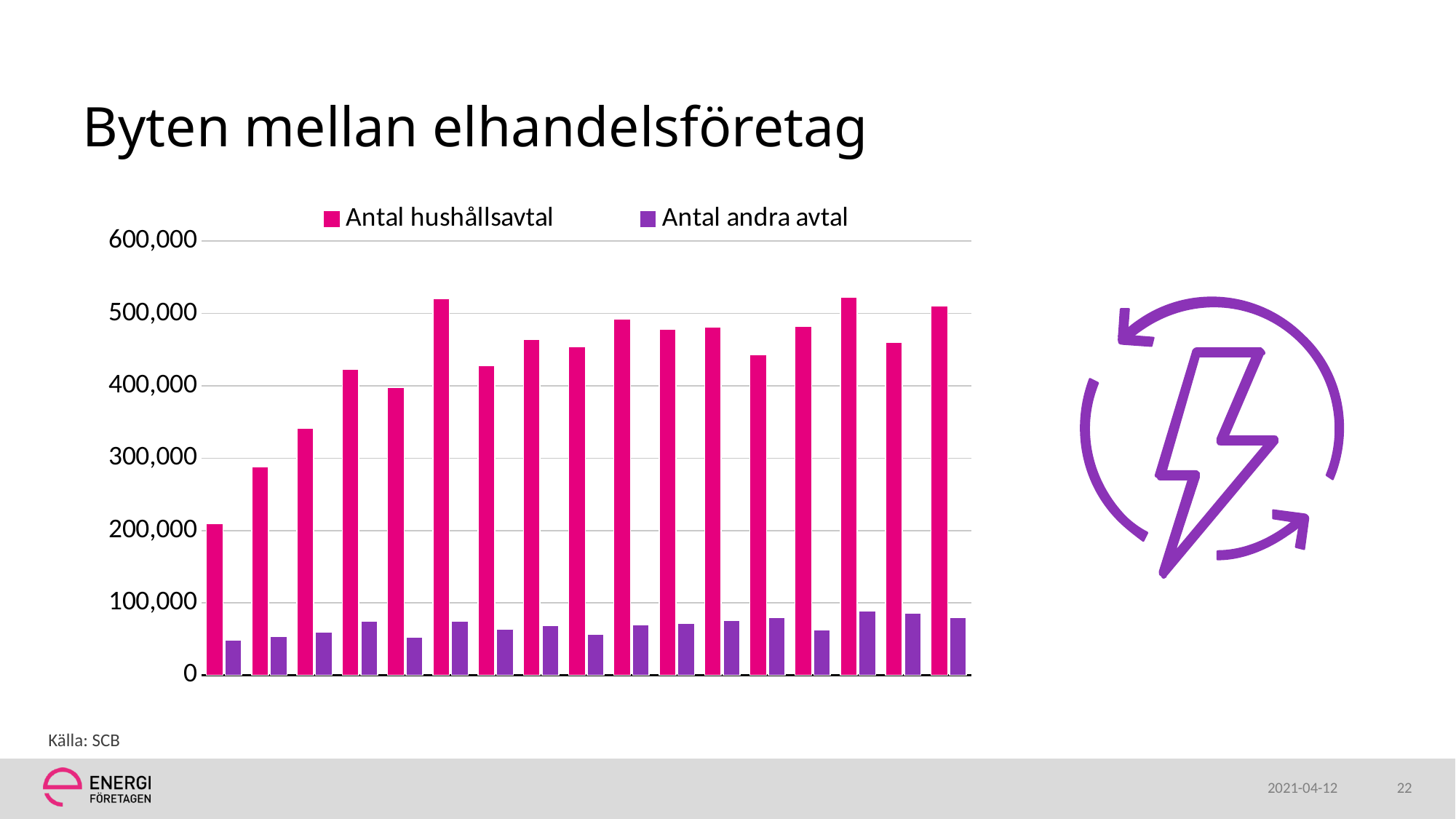
Are all of the Antal andra avtal bars below 100,000? yes Do the Antal hushållsavtal values overall rise or fall from left to right along the x axis? rise How many series does the legend list? 2 What kind of chart is shown on the slide? bar chart What is the title of the slide containing the chart? Byten mellan elhandelsföretag Which category has the lowest Antal hushållsavtal value? the first (leftmost) category Is the value of the last (rightmost) Antal hushållsavtal bar greater or less than 400,000? greater Which series has the larger values in every category, Antal hushållsavtal or Antal andra avtal? Antal hushållsavtal What are the two series named in the legend? Antal hushållsavtal and Antal andra avtal How many pairs of bars (categories) are plotted along the x axis? 17 Is the value of the first (leftmost) Antal hushållsavtal bar greater or less than 300,000? less